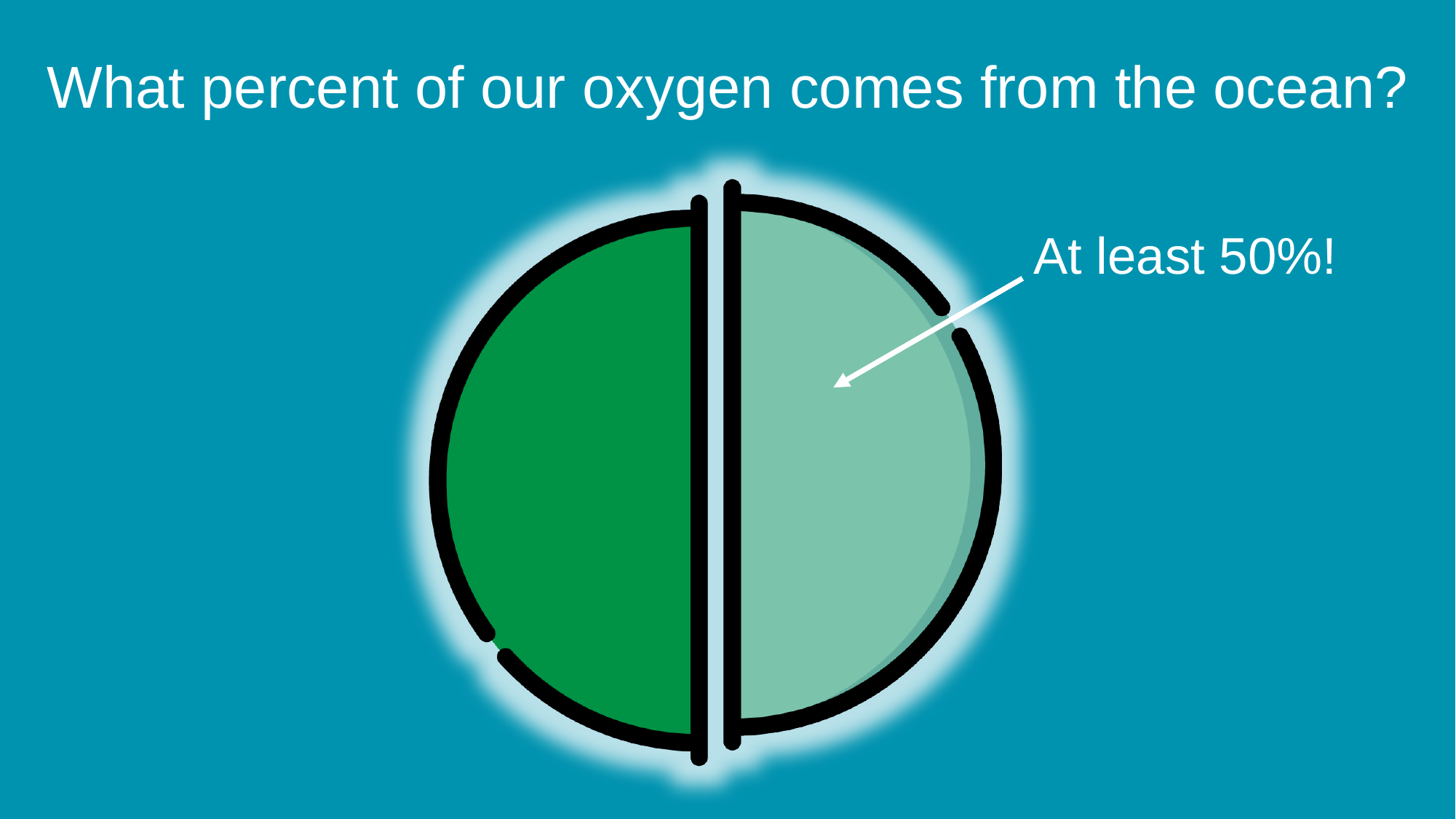
Is the share of oxygen that comes from the ocean, as labelled on the chart, less than 50% or at least 50%? at least 50% Which slice does the arrow labelled "At least 50%!" point to, the darker green one on the left or the lighter green one on the right? the lighter green one on the right What question does the slide title ask? What percent of our oxygen comes from the ocean? What kind of chart is shown on the slide? pie chart How many slices does the pie chart have? 2 What share of our oxygen does the lighter green slice represent, according to the label? At least 50%